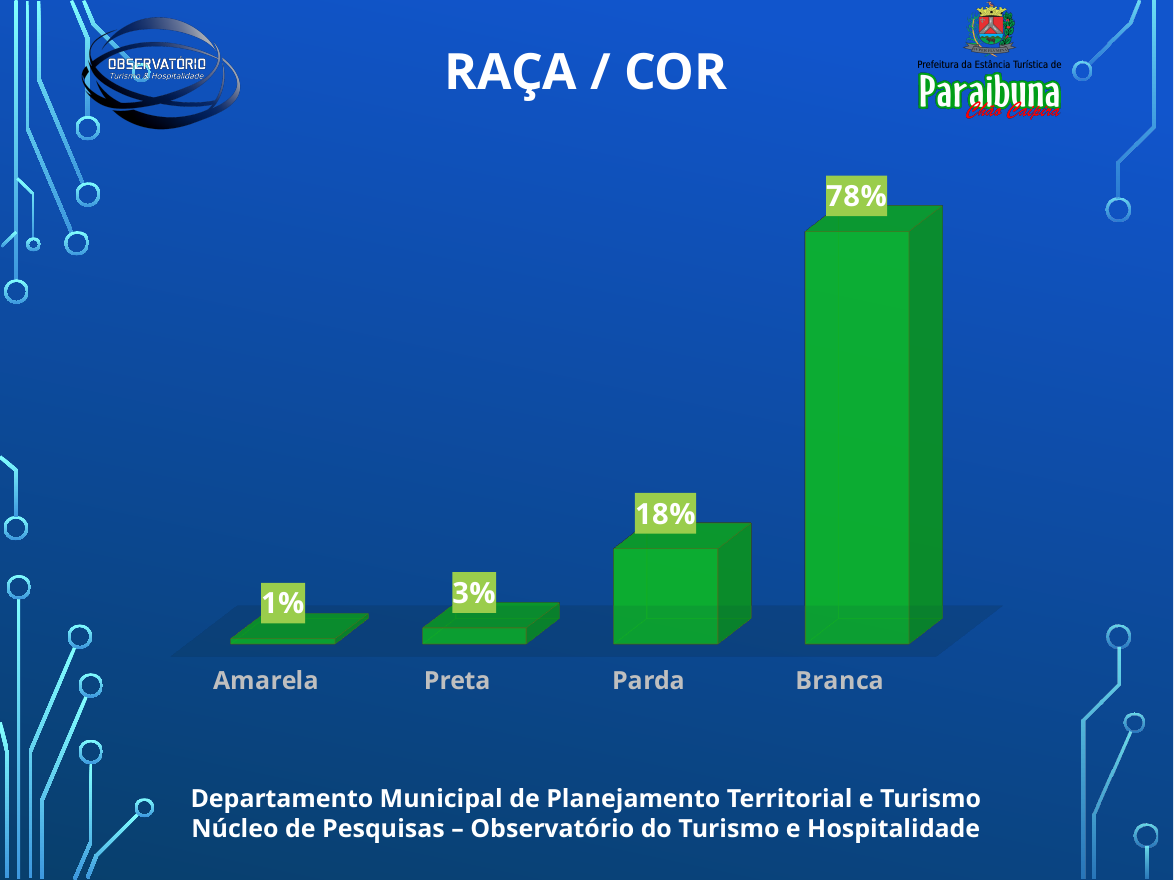
Which category has the lowest value? Amarela What is the value for Amarela? 1% What is the title of the chart? RAÇA / COR What is the value for Parda? 18% What is the value for Preta? 3% What is the value for Branca? 78% What is the difference between the values for Preta and Amarela? 2% Which is larger, the value for Parda or the value for Preta? Parda What kind of chart is shown on the slide? Bar chart Which category has the highest value? Branca How many categories are shown in the chart? 4 What is the difference between the values for Branca and Parda? 60%